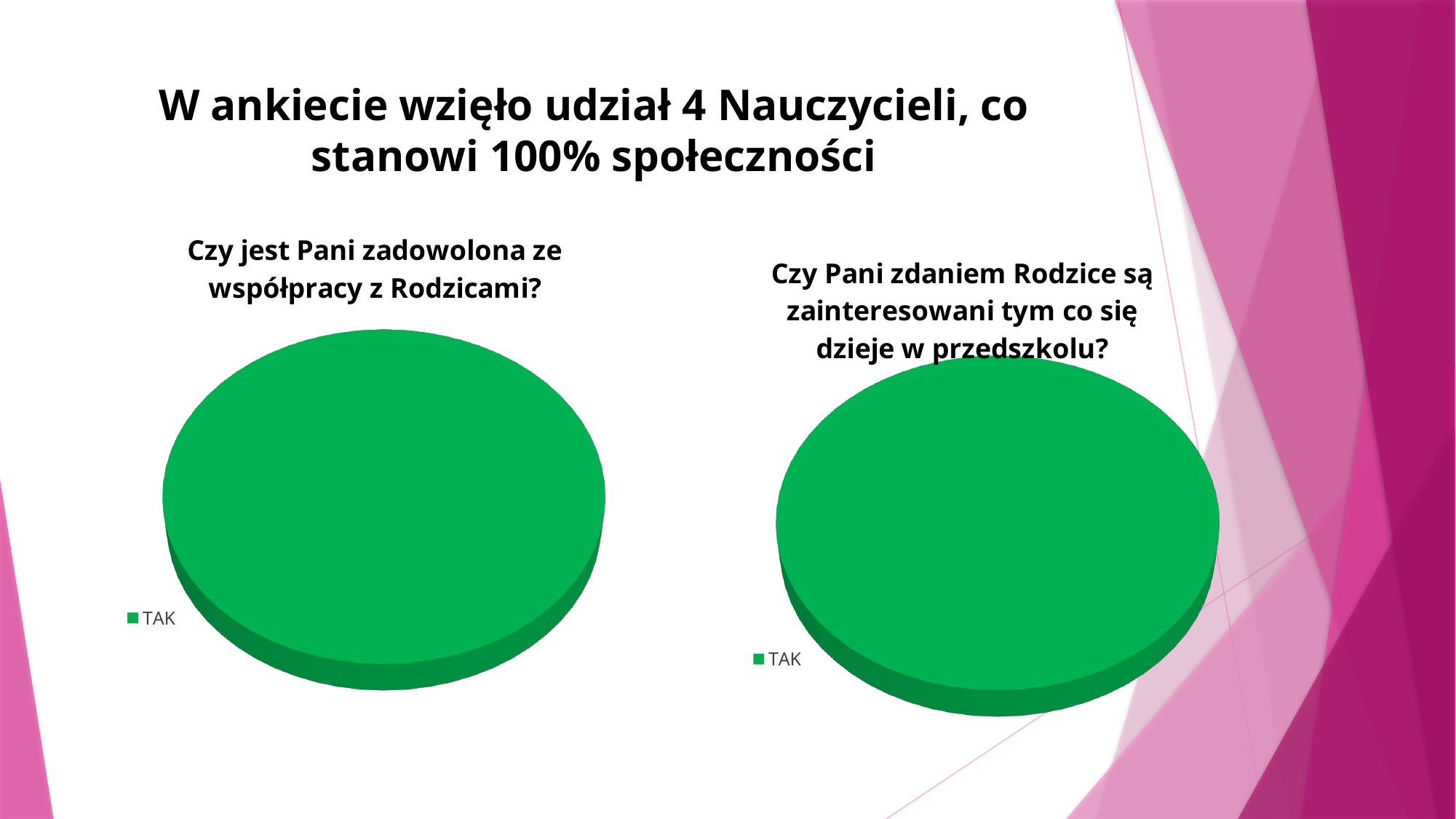
How many entries does the legend of the chart titled "Czy jest Pani zadowolona ze współpracy z Rodzicami?" list? 1 What colour is the "TAK" slice in the pie chart on the right of the slide? green What is the only legend entry of the pie chart on the left of the slide? TAK How many entries does the legend of the chart titled "Czy Pani zdaniem Rodzice są zainteresowani tym co się dzieje w przedszkolu?" list? 1 How many slices does the pie chart on the right of the slide have? 1 What kind of chart is the chart titled "Czy jest Pani zadowolona ze współpracy z Rodzicami?"? pie chart What kind of chart is the chart titled "Czy Pani zdaniem Rodzice są zainteresowani tym co się dzieje w przedszkolu?"? pie chart In the pie chart on the right of the slide, what share of the pie does the "TAK" slice take? 100% In the pie chart on the left of the slide, what share of the pie does the "TAK" slice take? 100% How many slices does the pie chart on the left of the slide have? 1